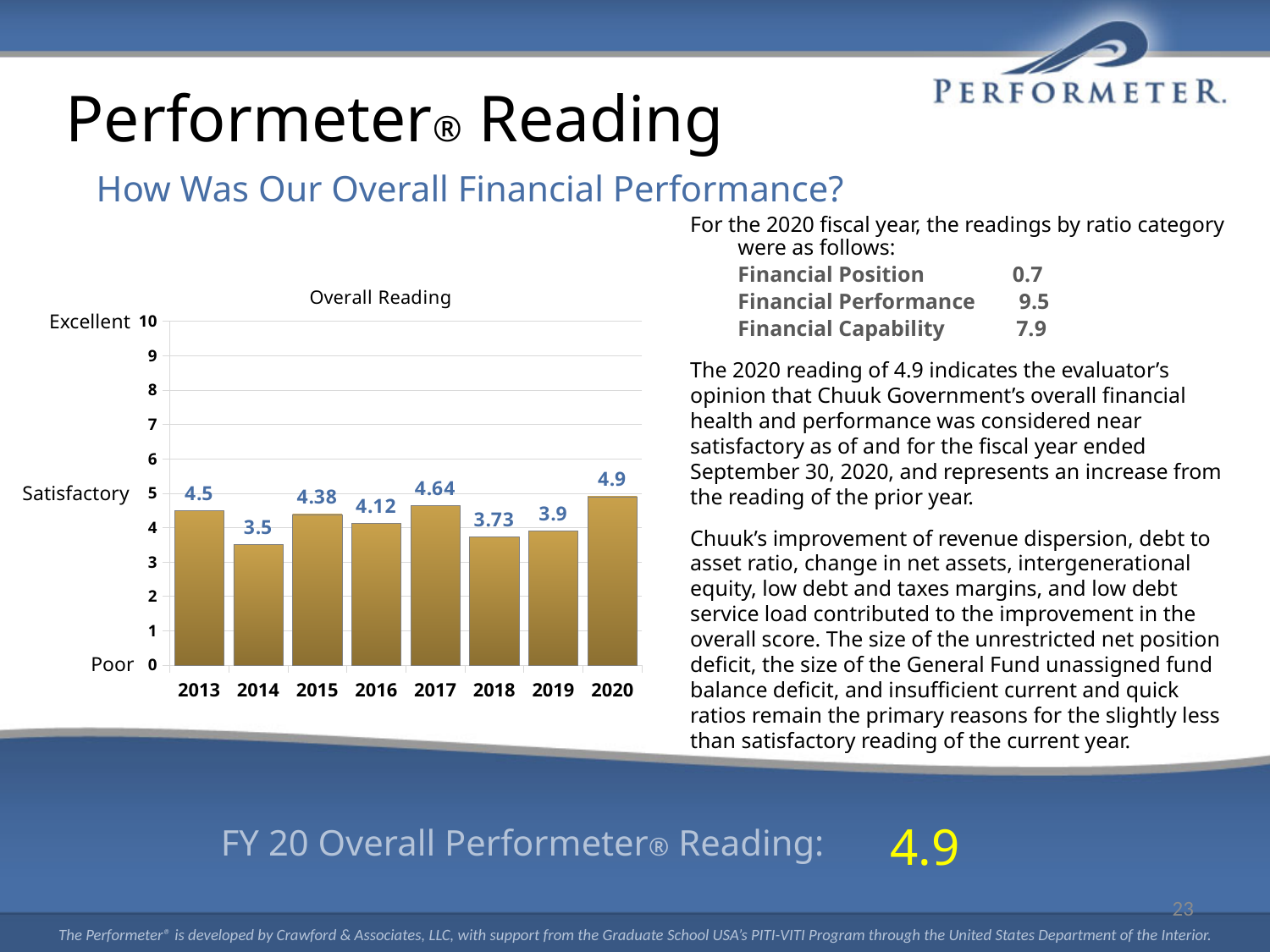
What is the difference between the Overall Reading for 2017 and 2016? 0.52 What kind of chart is the Overall Reading chart? bar chart What is the title of the chart on the slide? Overall Reading Which year has the lowest Overall Reading? 2014 Which year has a larger Overall Reading, 2015 or 2016? 2015 How many years are shown on the Overall Reading chart? 8 What is the Overall Reading value for 2020? 4.9 What is the difference between the Overall Reading for 2020 and 2019? 1 Which year has the highest Overall Reading? 2020 What is the Overall Reading value for 2013? 4.5 Is the Overall Reading for 2014 greater or less than 4? less What is the Overall Reading value for 2018? 3.73